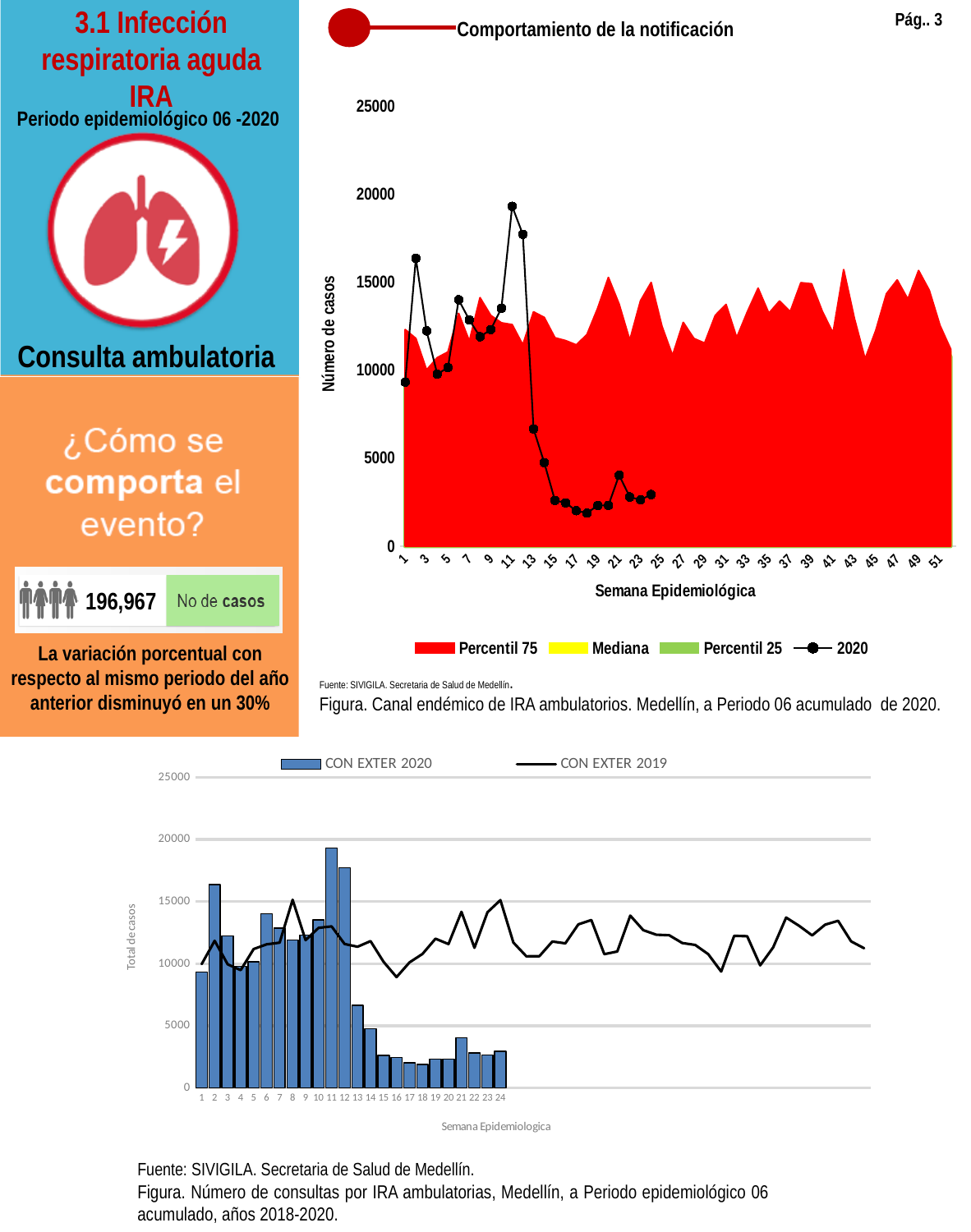
In the bottom chart, how many bars are plotted for CON EXTER 2020? 24 In the top chart 'Comportamiento de la notificación', does the 2020 line rise or fall between week 12 and week 17? fall In the bottom chart, how many series does the legend list? 2 In the top chart 'Comportamiento de la notificación', what is the label of the x axis? Semana Epidemiológica In the bottom chart, is the CON EXTER 2020 bar for week 2 larger or smaller than the bar for week 3? larger In the bottom chart, which week has the highest CON EXTER 2020 bar? 11 In the top chart 'Comportamiento de la notificación', which colour represents Percentil 75? red In the bottom chart, what kind of chart is used for the CON EXTER 2020 series? bar chart In the top chart 'Comportamiento de la notificación', at which epidemiological week does the 2020 line reach its highest value? 11 In the top chart 'Comportamiento de la notificación', how many series does the legend list? 4 In the top chart 'Comportamiento de la notificación', is the 2020 value at week 17 greater or less than 5000? less In the top chart 'Comportamiento de la notificación', is the 2020 value at week 11 greater or less than 15000? greater